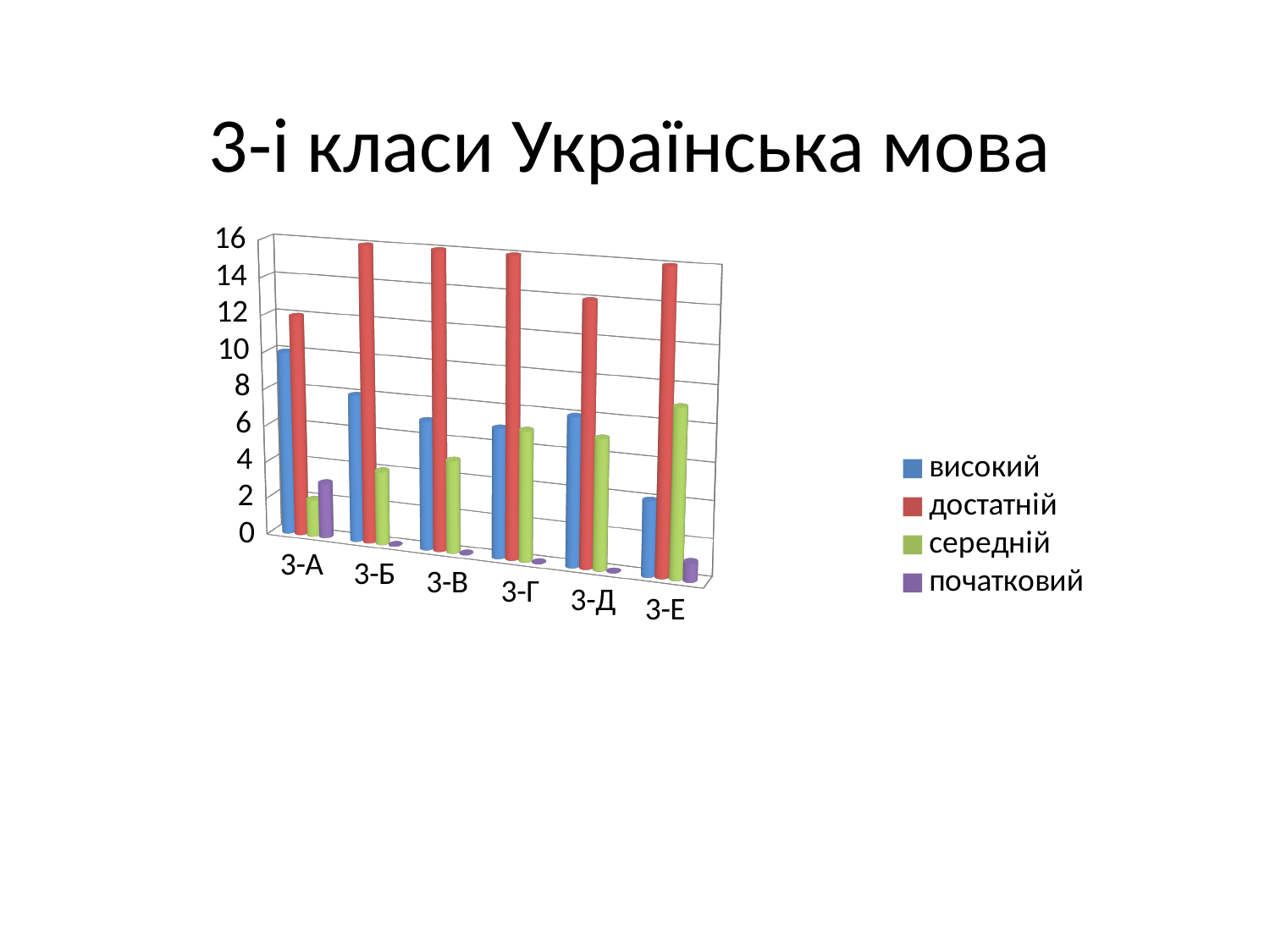
Is the value for високий in class 3-А greater or less than 8? greater Is the value for середній in class 3-А greater or less than 4? less In class 3-А, which is larger: високий or достатній? достатній Which class has the highest value for the середній series? 3-Е Which series is shown in red in the legend? достатній Is the value for достатній in class 3-Б greater or less than 14? greater Which class has the highest value for the високий series? 3-А How many classes (categories) are shown on the x axis? 6 Which class has the lowest value for the високий series? 3-Е What kind of chart is shown on the slide? bar chart How many series does the legend list? 4